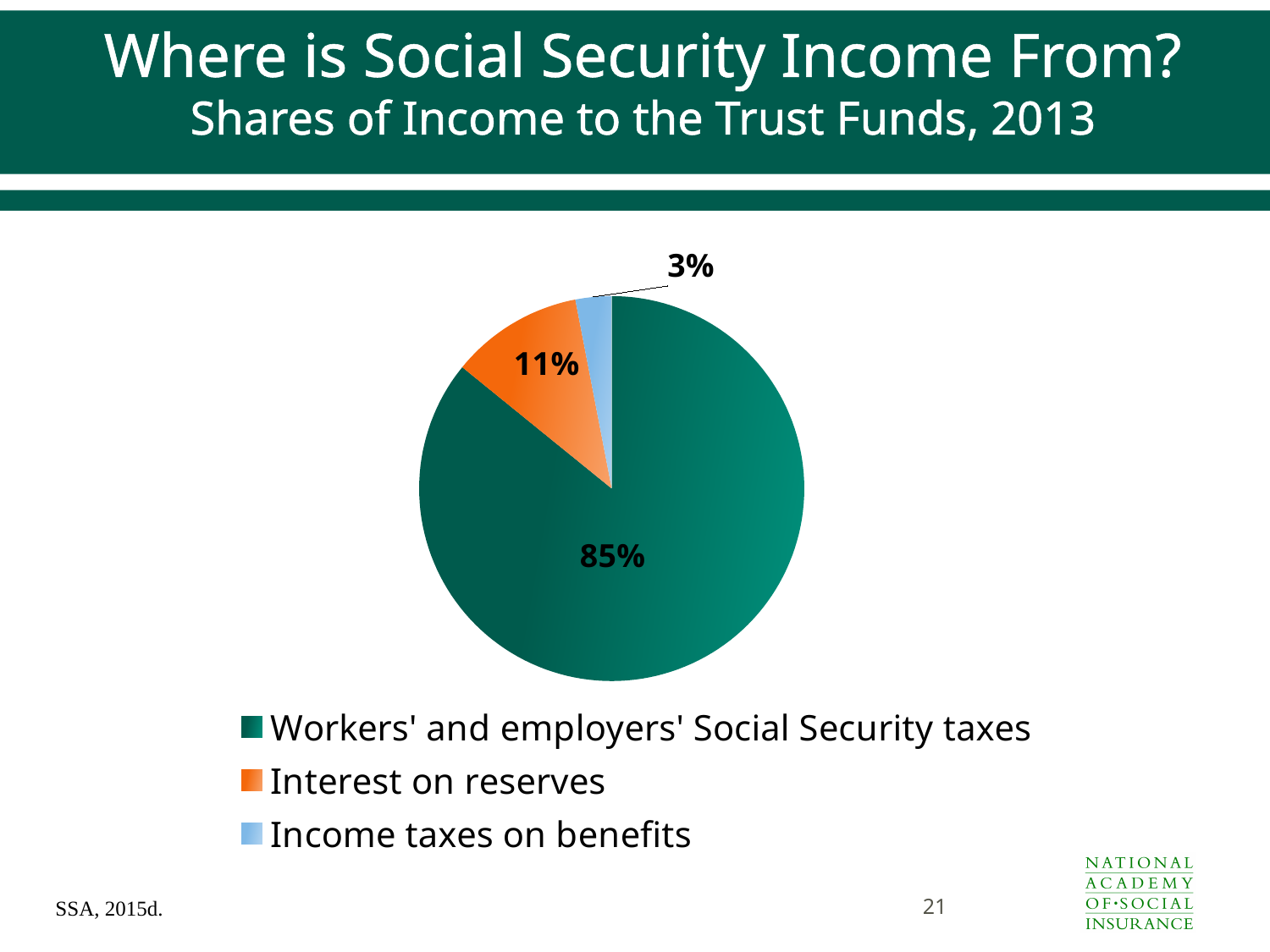
What year do the shares of income to the trust funds refer to? 2013 Which is larger: the share from interest on reserves or the share from income taxes on benefits? Interest on reserves What colour is the slice for interest on reserves? Orange What share of income to the trust funds comes from income taxes on benefits? 3% What share of income to the trust funds comes from workers' and employers' Social Security taxes? 85% Which source accounts for the smallest share of income to the trust funds? Income taxes on benefits How many slices does the pie chart have? 3 Which source accounts for the largest share of income to the trust funds? Workers' and employers' Social Security taxes How many percentage points larger is the share from workers' and employers' Social Security taxes than the share from interest on reserves? 74 What share of income to the trust funds comes from interest on reserves? 11% How many percentage points larger is the share from interest on reserves than the share from income taxes on benefits? 8 What kind of chart is shown on the slide? Pie chart